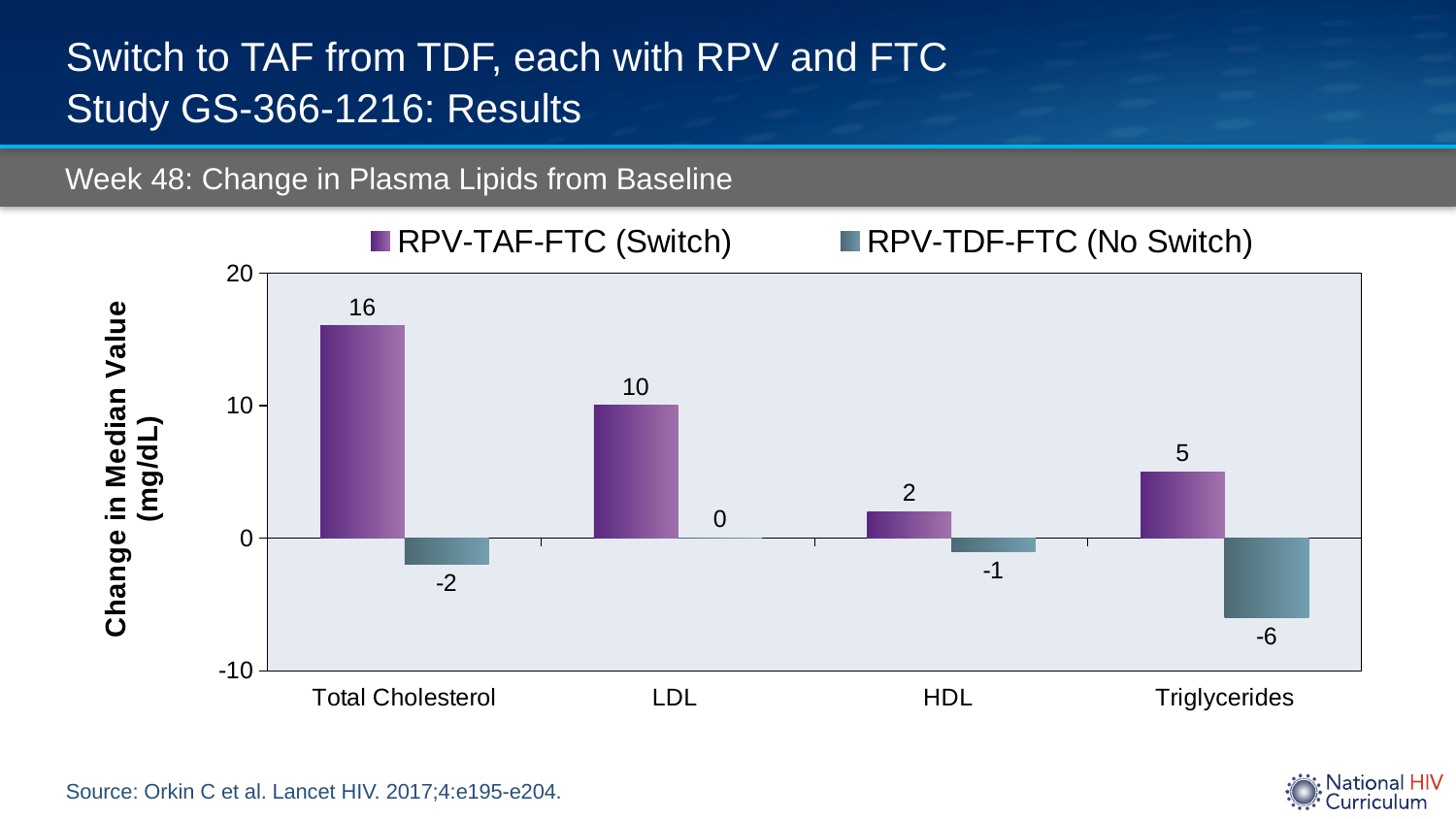
How many lipid categories are shown on the x axis? 4 Which lipid category has the lowest value for the RPV-TDF-FTC (No Switch) group? Triglycerides How many series does the legend list? 2 What is the label of the y axis? Change in Median Value (mg/dL) Which lipid category has the highest value for the RPV-TAF-FTC (Switch) group? Total Cholesterol What kind of chart is shown on the slide? Bar chart Which group has the larger value for HDL, RPV-TAF-FTC (Switch) or RPV-TDF-FTC (No Switch)? RPV-TAF-FTC (Switch) Is the value for LDL in the RPV-TAF-FTC (Switch) group greater or less than 0? greater What is the change in median value for Triglycerides in the RPV-TDF-FTC (No Switch) group? -6 What is the change in median value for LDL in the RPV-TDF-FTC (No Switch) group? 0 What is the difference between the RPV-TAF-FTC (Switch) and RPV-TDF-FTC (No Switch) values for Total Cholesterol? 18 What is the change in median value for Total Cholesterol in the RPV-TAF-FTC (Switch) group? 16